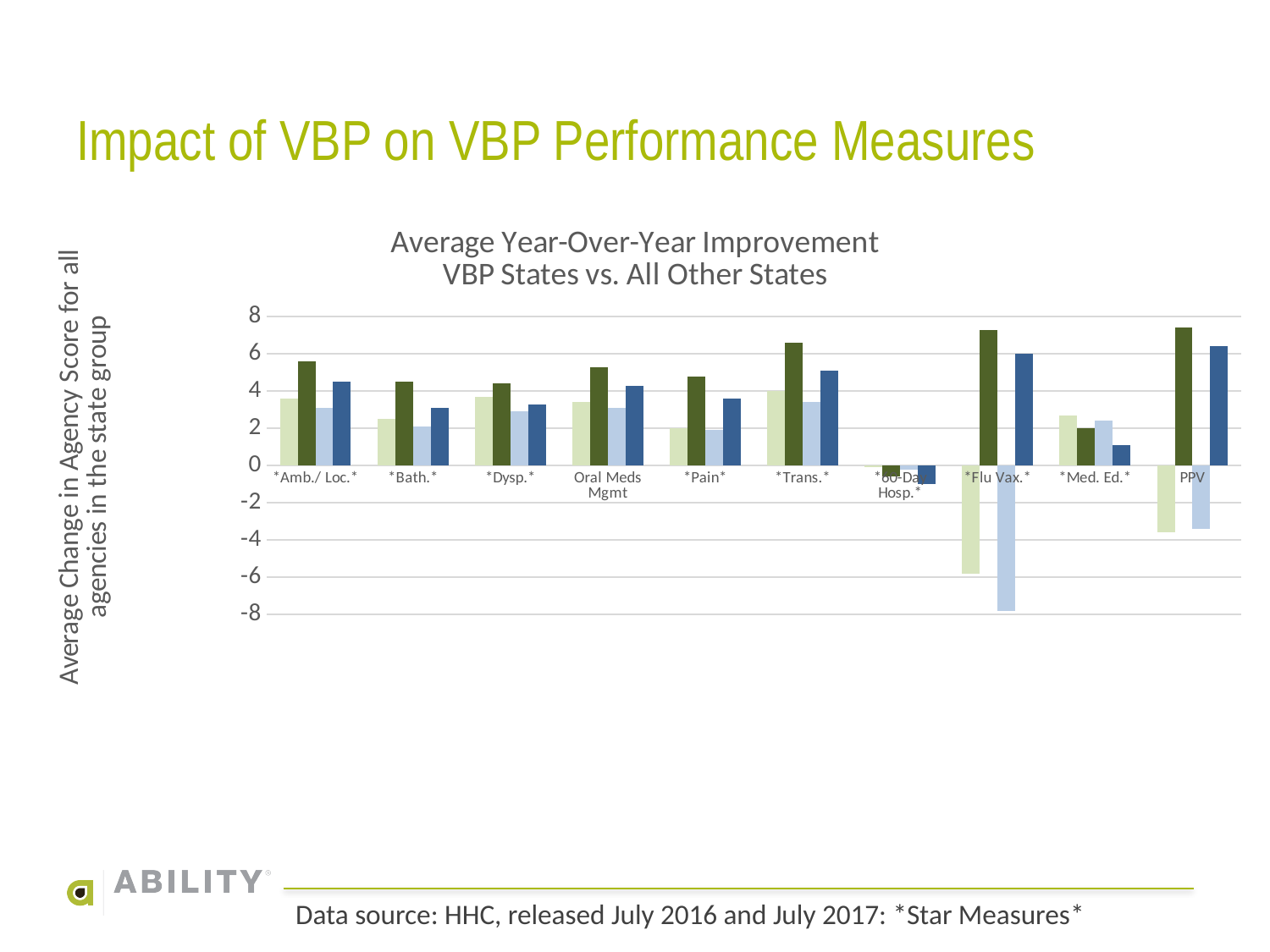
Is the light blue bar for *Flu Vax.* greater or less than -6? less Is the dark blue bar for *Trans.* greater or less than 4? greater How many categories are shown along the x axis of the chart? 10 Is the dark green bar for PPV greater or less than 6? greater Which category contains the lowest bar in the chart? *Flu Vax.* What kind of chart is shown on the slide? Bar chart Which is larger, the dark green bar for *Trans.* or the dark green bar for *Pain*? *Trans.* What is the label on the vertical axis of the chart? Average Change in Agency Score for all agencies in the state group What is the title of the chart? Average Year-Over-Year Improvement VBP States vs. All Other States